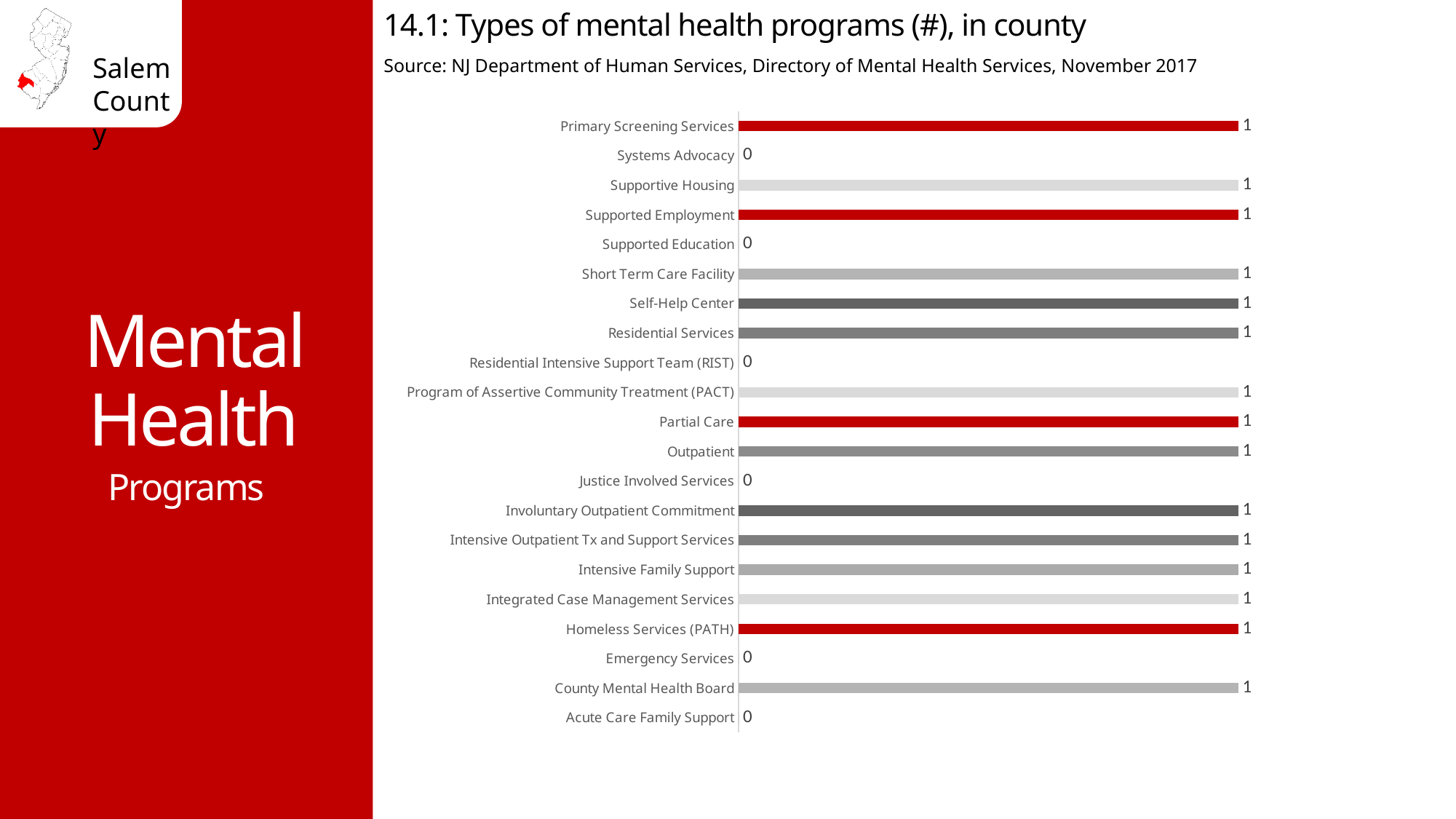
How many categories have a value of 0? 6 What is the value for Emergency Services? 0 Which is larger, the value for Partial Care or the value for Justice Involved Services? Partial Care What kind of chart is shown on the slide? Bar chart What is the value for County Mental Health Board? 1 What is the value for Residential Intensive Support Team (RIST)? 0 How many categories are shown in the chart? 21 What is the value for Systems Advocacy? 0 What is the value for Homeless Services (PATH)? 1 What is the title of the chart? 14.1: Types of mental health programs (#), in county What is the difference between the value for Supported Employment and the value for Supported Education? 1 What is the value for Primary Screening Services? 1